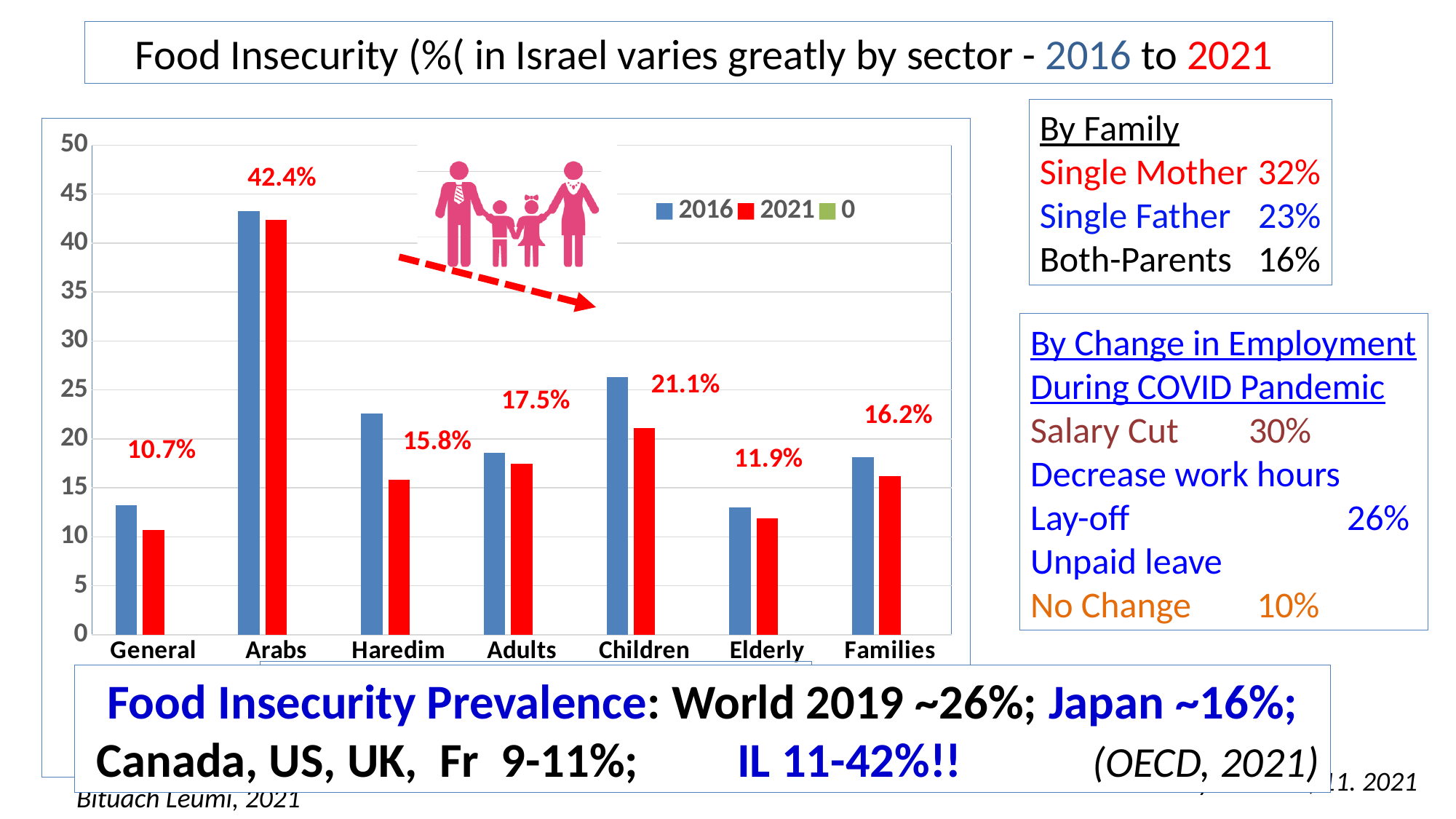
Which has the larger 2021 value, Adults or Haredim? Adults What is the difference between the 2021 values for Arabs and General? 31.7 percentage points Which colour represents the 2021 series in the chart? Red Is the 2016 value for Arabs greater or less than 40? greater What is the 2021 food insecurity value for Elderly? 11.9% How many sectors are shown on the x axis of the chart? 7 What is the 2021 food insecurity value for Children? 21.1% Is the 2016 value for General greater or less than 15? less What is the 2021 food insecurity value for Arabs? 42.4% Which sector has the lowest 2021 food insecurity value? General What kind of chart is shown on the slide? Bar chart Which sector has the highest 2021 food insecurity value? Arabs